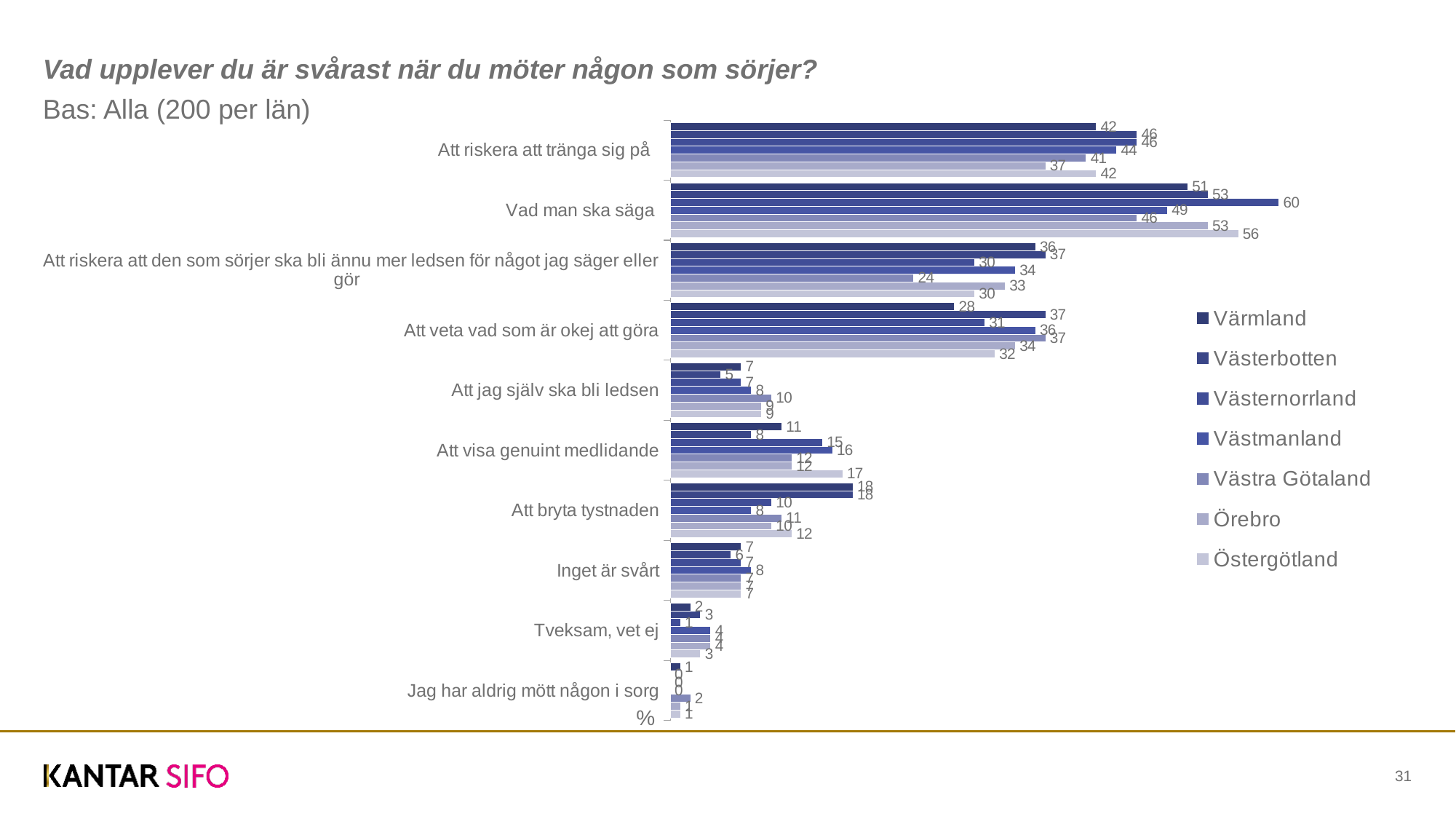
What is the title of the chart on the slide? Vad upplever du är svårast när du möter någon som sörjer? How many series (län) does the legend list? 7 What is the value for Värmland in the category 'Att veta vad som är okej att göra'? 28 What kind of chart is shown on the slide? Bar chart What is the value for Värmland in the category 'Vad man ska säga'? 51 In the category 'Att bryta tystnaden', which is larger: Värmland or Västmanland? Värmland Which län has the lowest value in the category 'Vad man ska säga'? Västra Götaland How many categories (answer options) are plotted on the chart? 10 What is the highest value shown anywhere on the chart, and for which category and län? 60, Vad man ska säga, Västernorrland What is the value for Västra Götaland in the category 'Att riskera att den som sörjer ska bli ännu mer ledsen för något jag säger eller gör'? 24 In the category 'Vad man ska säga', what is the difference between Västernorrland and Västra Götaland? 14 What is the value for Östergötland in the category 'Vad man ska säga'? 56